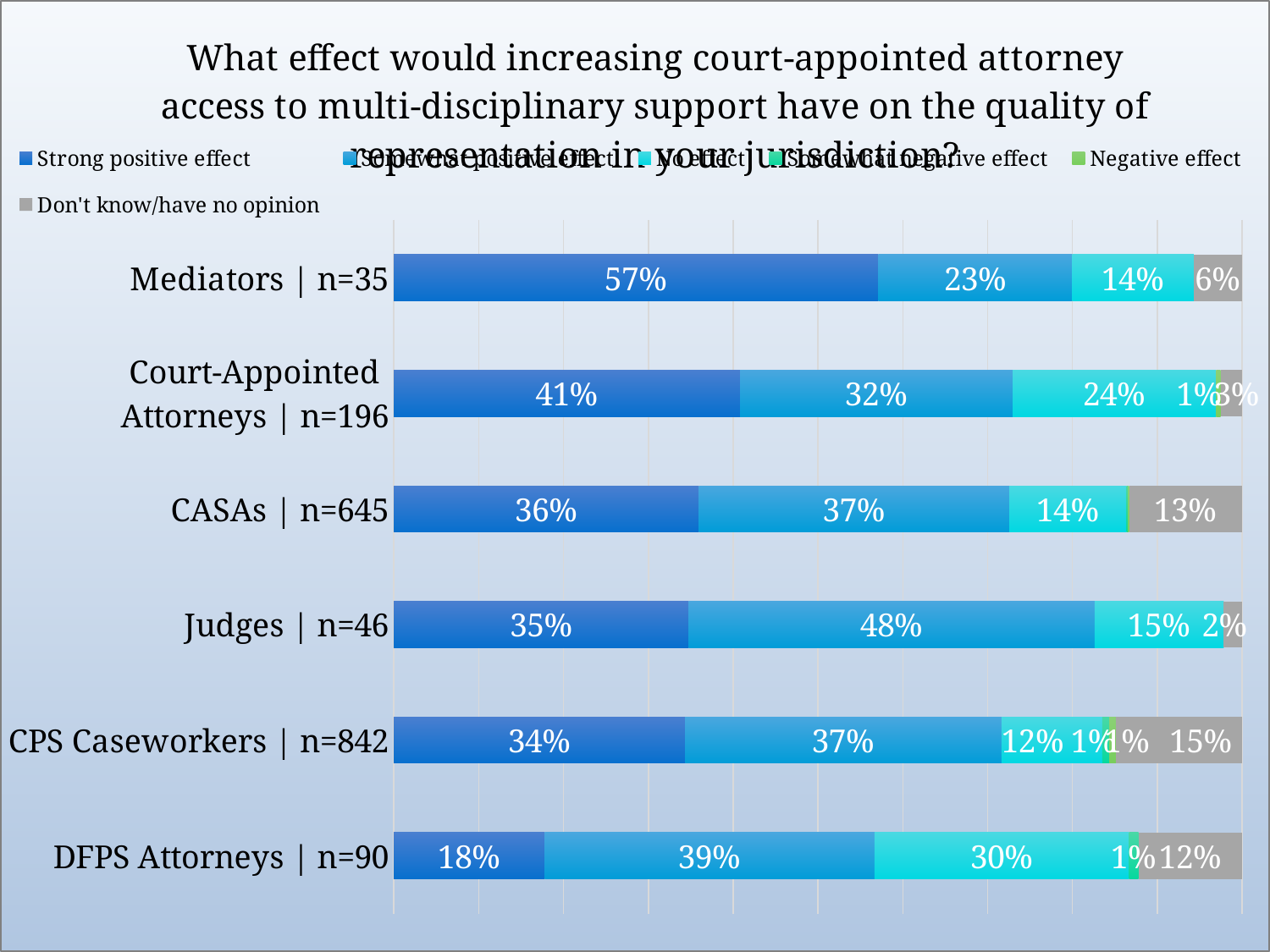
What percentage of Judges reported a somewhat positive effect? 48% What percentage of CASAs answered 'Don't know/have no opinion'? 13% Which group has the highest share reporting a strong positive effect? Mediators | n=35 Which group has the lowest share reporting a strong positive effect? DFPS Attorneys | n=90 Which group has the highest share reporting a somewhat positive effect? Judges | n=46 How many series does the legend list? 6 What type of chart is shown on the slide? Stacked bar chart What percentage of Mediators reported a strong positive effect? 57% What is the difference in percentage points between the strong positive effect share for Mediators and for DFPS Attorneys? 39 percentage points For CPS Caseworkers, which is larger: the strong positive effect share or the somewhat positive effect share? Somewhat positive effect How many respondent groups are shown on the chart? 6 What percentage of DFPS Attorneys reported no effect? 30%